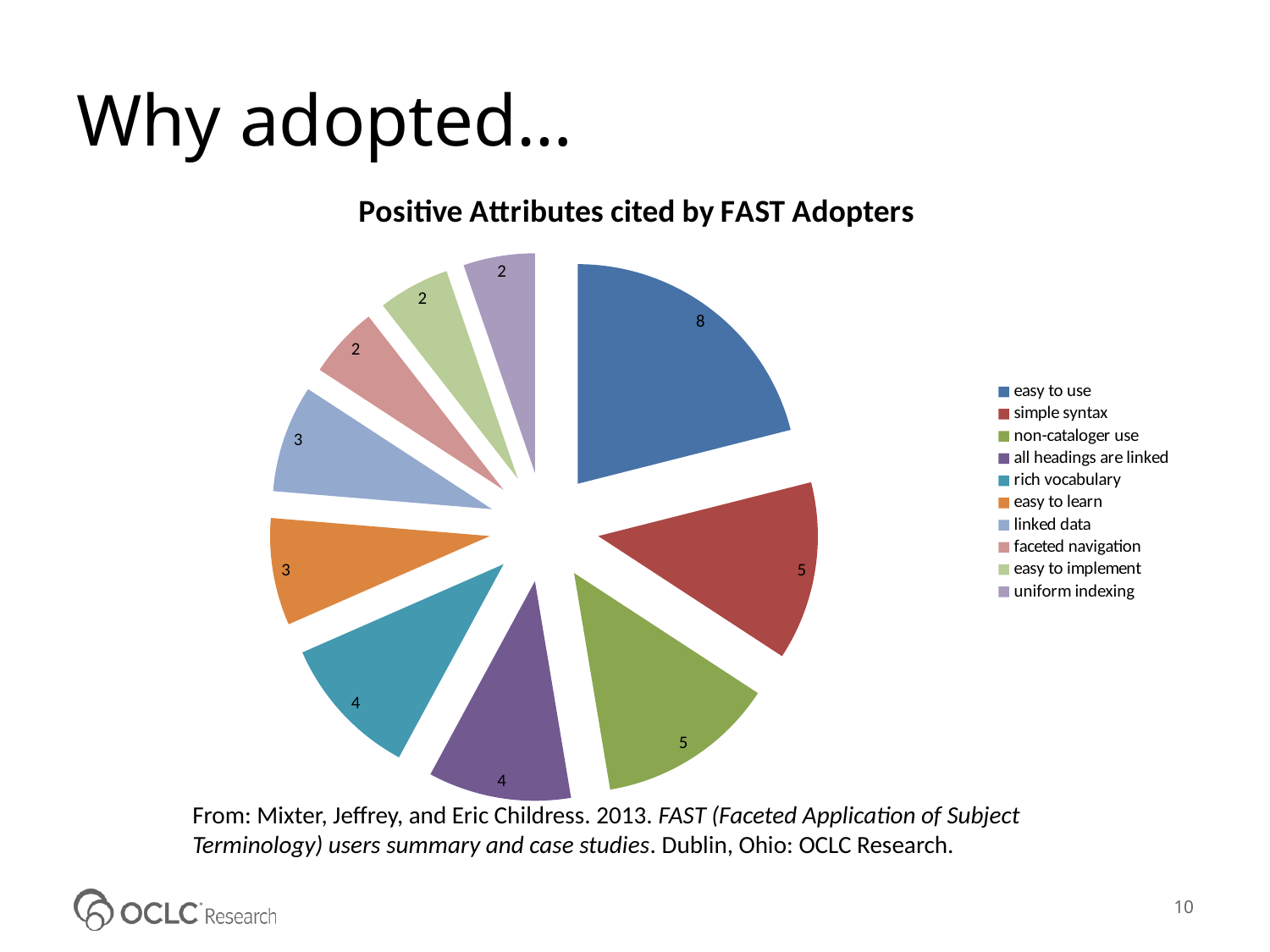
What is the value for "uniform indexing"? 2 What is the title of the chart? Positive Attributes cited by FAST Adopters What is the total of all the values in the pie chart? 38 What is the value for "simple syntax"? 5 How many categories does the legend list? 10 What is the value for "easy to use"? 8 Which attribute has the largest slice of the pie? easy to use What is the difference between the values for "easy to use" and "easy to learn"? 5 What is the value for "rich vocabulary"? 4 What is the value for "linked data"? 3 What kind of chart is shown on the slide? pie chart Which is larger, the value for "non-cataloger use" or the value for "all headings are linked"? non-cataloger use